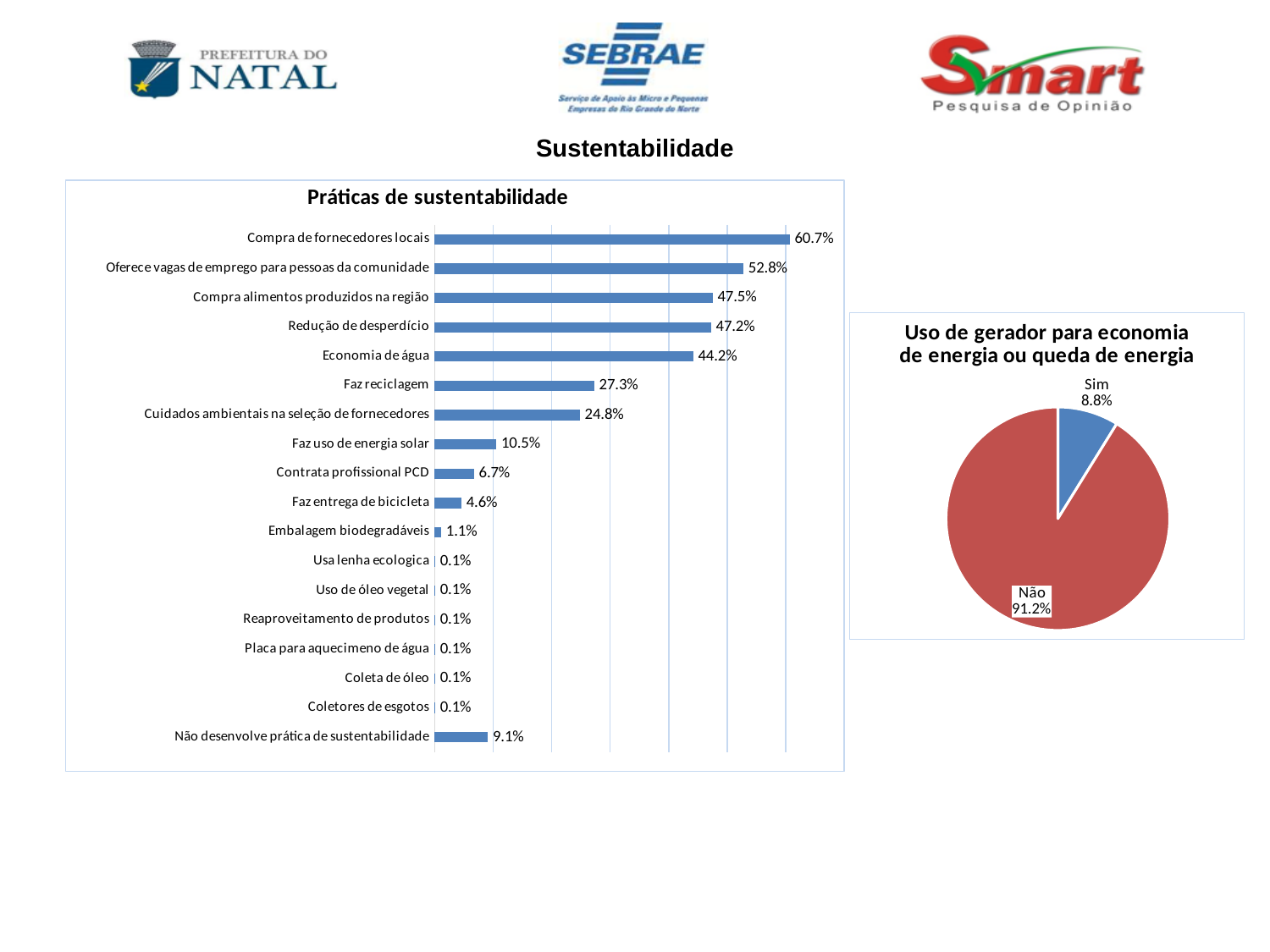
In the 'Práticas de sustentabilidade' chart, what is the value for 'Compra de fornecedores locais'? 60.7% In the 'Práticas de sustentabilidade' chart, what is the difference between 'Compra de fornecedores locais' and 'Oferece vagas de emprego para pessoas da comunidade'? 7.9% In the 'Uso de gerador para economia de energia ou queda de energia' chart, what share is 'Não'? 91.2% In the 'Práticas de sustentabilidade' chart, what is the value for 'Faz reciclagem'? 27.3% In the 'Práticas de sustentabilidade' chart, which category has the highest value? Compra de fornecedores locais What kind of chart is 'Uso de gerador para economia de energia ou queda de energia'? Pie chart In the 'Uso de gerador para economia de energia ou queda de energia' chart, what colour is the 'Não' slice? Red What kind of chart is 'Práticas de sustentabilidade'? Bar chart In the 'Uso de gerador para economia de energia ou queda de energia' chart, what share is 'Sim'? 8.8% How many categories are shown in the 'Práticas de sustentabilidade' chart? 18 In the 'Práticas de sustentabilidade' chart, which is larger: 'Economia de água' or 'Faz reciclagem'? Economia de água In the 'Práticas de sustentabilidade' chart, what is the value for 'Não desenvolve prática de sustentabilidade'? 9.1%